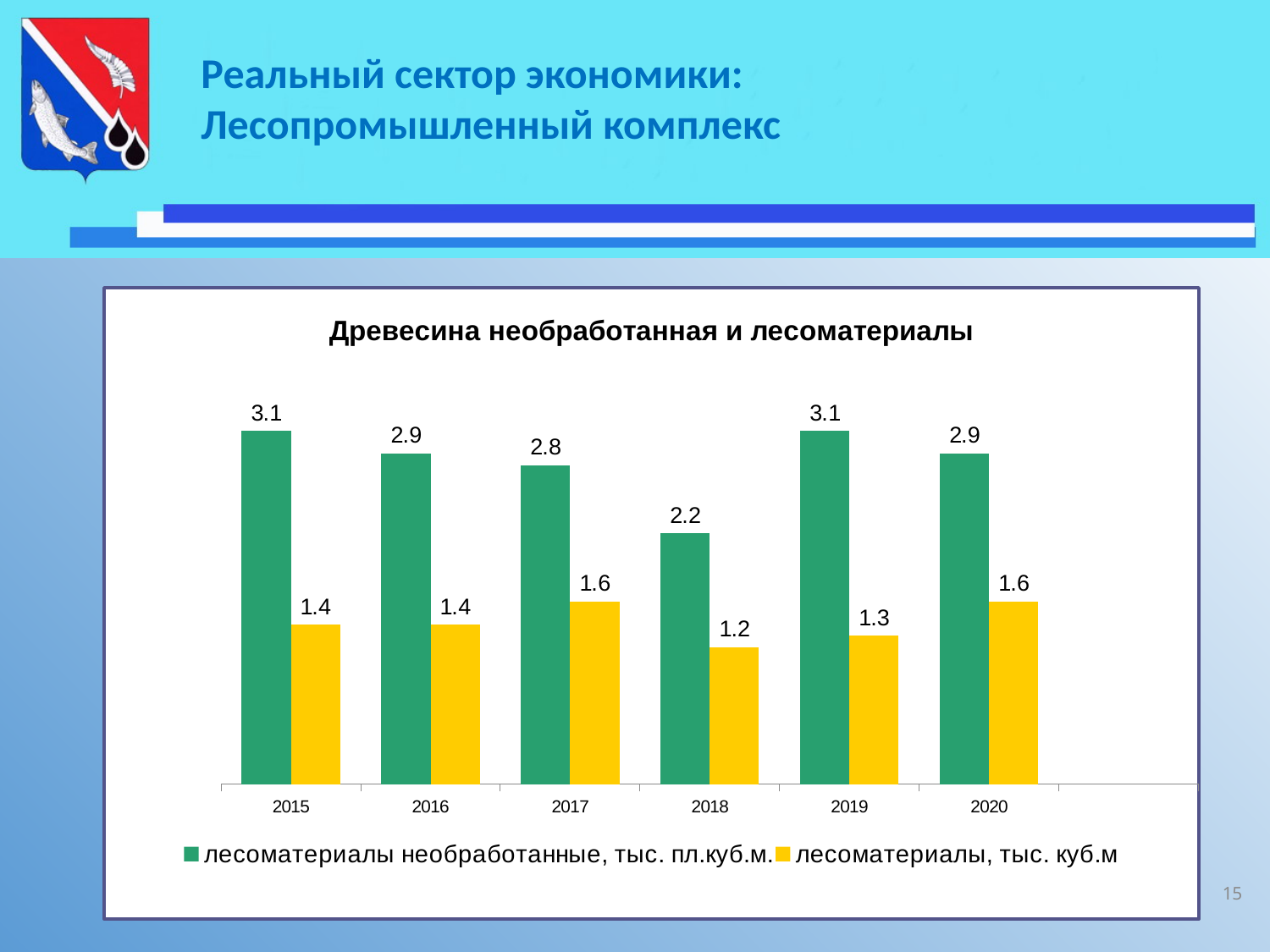
In which year is the value for лесоматериалы, тыс. куб.м the lowest? 2018 What is the difference between the лесоматериалы необработанные values for 2017 and 2018? 0.6 What is the value for лесоматериалы, тыс. куб.м in 2019? 1.3 What is the value for лесоматериалы, тыс. куб.м in 2020? 1.6 How many years are shown on the x axis? 6 In which year is the value for лесоматериалы необработанные, тыс. пл.куб.м the lowest? 2018 What is the difference between the two series' values in 2015? 1.7 Which is larger in 2019: лесоматериалы необработанные, тыс. пл.куб.м or лесоматериалы, тыс. куб.м? лесоматериалы необработанные, тыс. пл.куб.м What is the value for лесоматериалы необработанные, тыс. пл.куб.м in 2018? 2.2 How many series does the legend list? 2 What kind of chart is shown on the slide? bar chart What is the title of the chart? Древесина необработанная и лесоматериалы